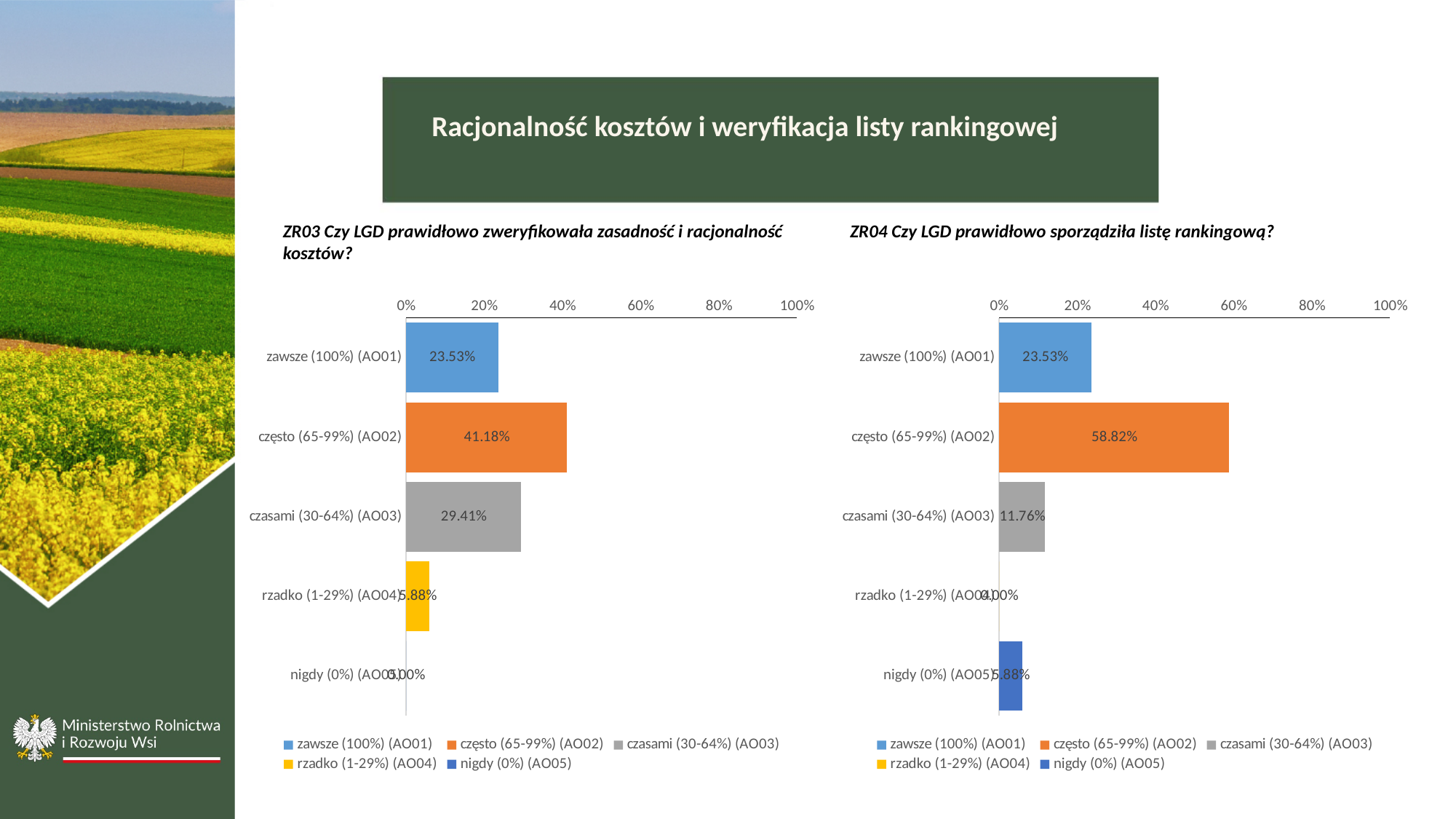
In the ZR03 chart (left), what is the difference between często (65-99%) (AO02) and czasami (30-64%) (AO03)? 11.77% In the ZR04 chart (right), is the value for często (65-99%) (AO02) greater or less than 40%? greater In the ZR03 chart (left), which category has the highest value? często (65-99%) (AO02) In the ZR04 chart (right), what is the value for czasami (30-64%) (AO03)? 11.76% What kind of chart is the ZR04 chart (right)? bar chart In the ZR04 chart (right), what is the value for często (65-99%) (AO02)? 58.82% In the ZR03 chart (left), what is the value for często (65-99%) (AO02)? 41.18% How many categories does the ZR03 chart (left) show? 5 In the ZR04 chart (right), which category has the lowest value? rzadko (1-29%) (AO04) Which is larger: czasami (30-64%) (AO03) in the ZR03 chart or czasami (30-64%) (AO03) in the ZR04 chart? ZR03 chart In the ZR04 chart (right), what is the difference between często (65-99%) (AO02) and zawsze (100%) (AO01)? 35.29% In the ZR03 chart (left), what is the value for rzadko (1-29%) (AO04)? 5.88%